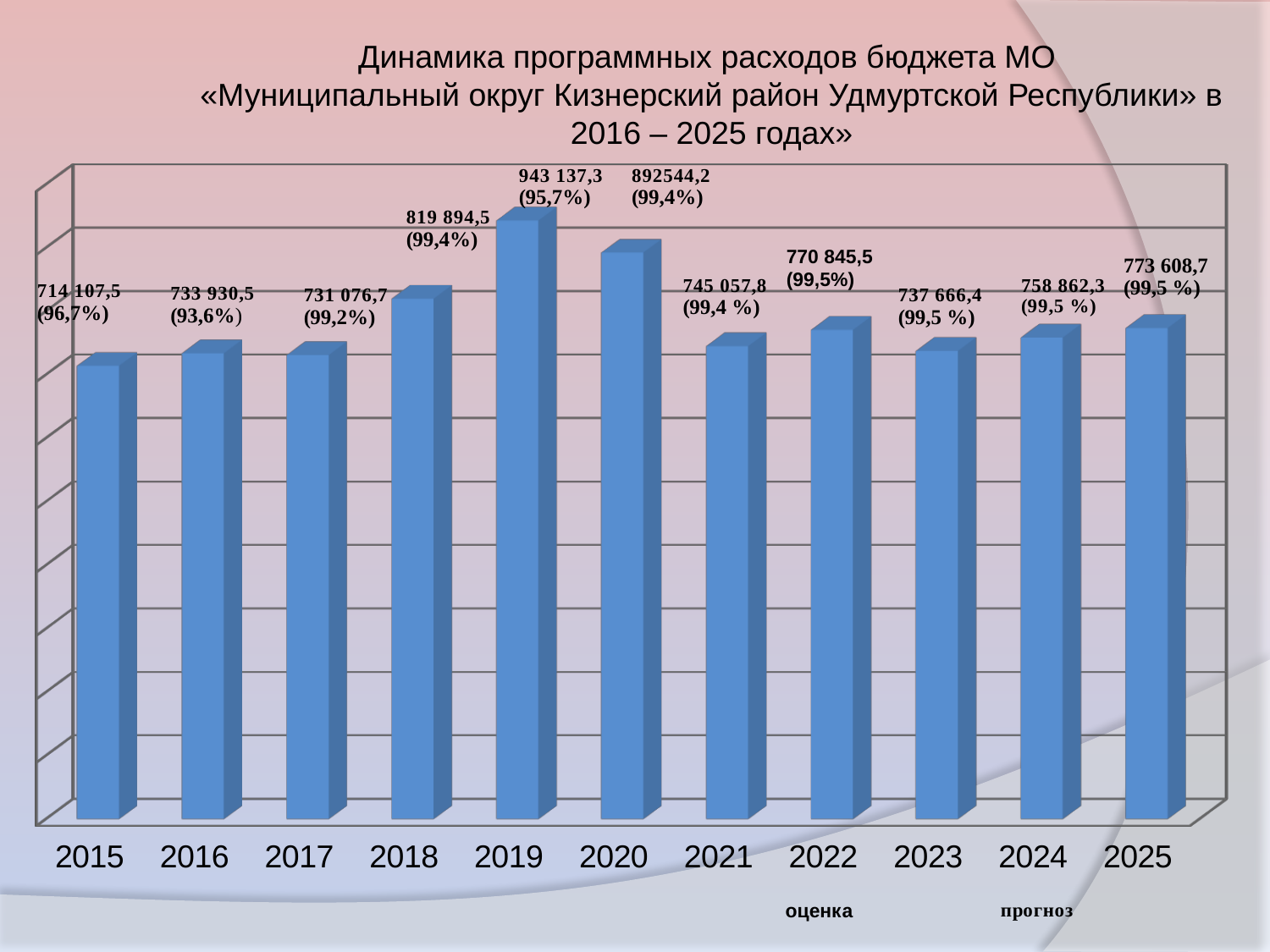
How many years (bars) are plotted on the chart? 11 What is the value shown for 2021? 745 057,8 What is the value shown for 2018? 819 894,5 Which is larger, the value for 2022 or the value for 2021? 2022 What type of chart is shown on the slide? Bar chart What is the difference between the values for 2019 and 2020? 50 593,1 Which year has the lowest value? 2015 Do the values rise or fall from 2019 to 2021? Fall What is the value shown for 2025? 773 608,7 Which year has the highest value? 2019 What is the difference between the values for 2018 and 2017? 88 817,8 What percentage is shown in parentheses for 2016? 93,6%